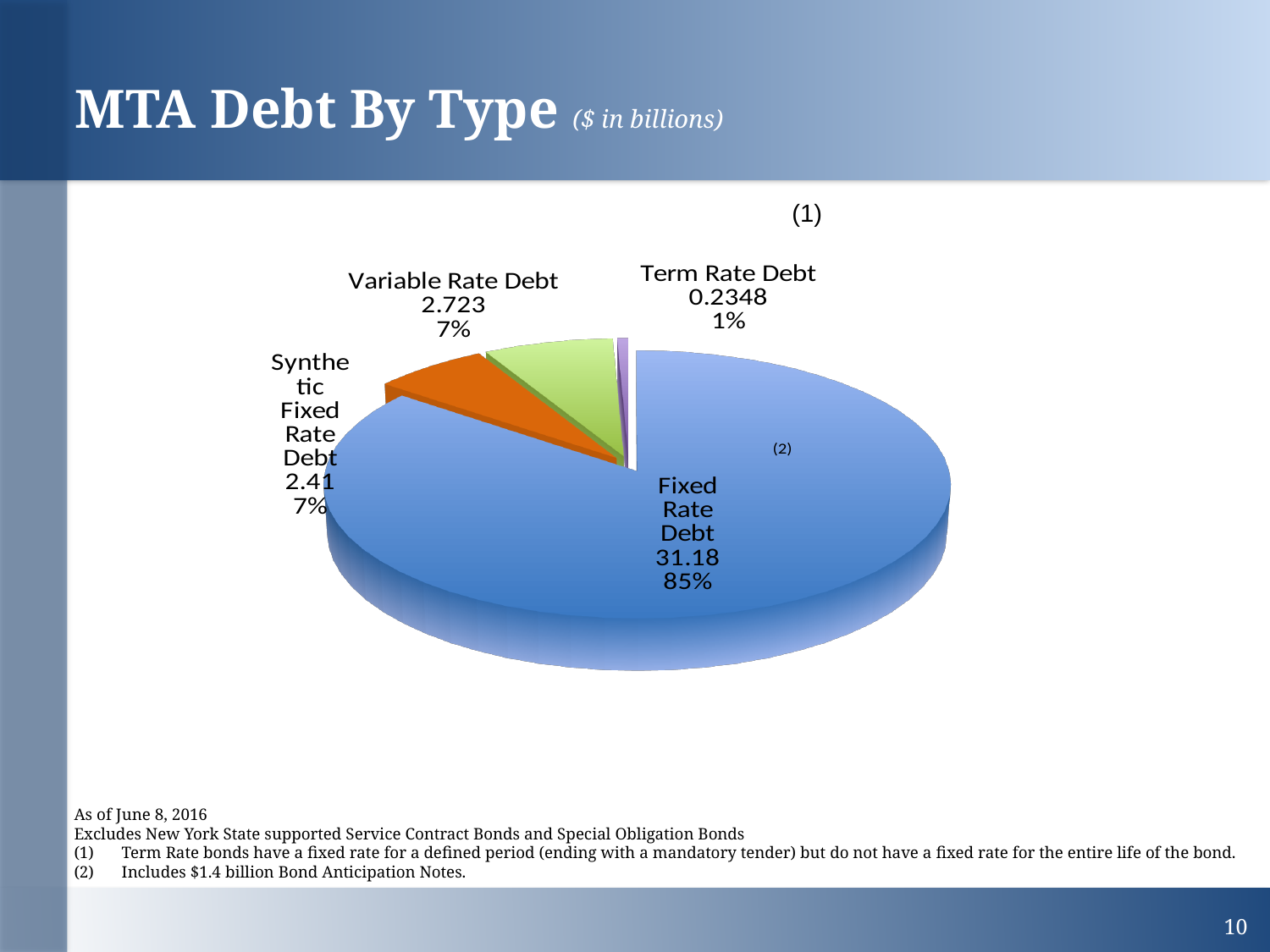
What percentage share of the pie does Term Rate Debt represent? 1% What is the value for Term Rate Debt? 0.2348 What percentage share of the pie does Fixed Rate Debt represent? 85% What is the value for Variable Rate Debt? 2.723 What is the value for Fixed Rate Debt? 31.18 What is the difference between the values for Variable Rate Debt and Synthetic Fixed Rate Debt? 0.313 Which debt type has the largest share of the pie? Fixed Rate Debt What is the value for Synthetic Fixed Rate Debt? 2.41 Which debt type has the smallest share of the pie? Term Rate Debt What kind of chart is shown on the slide? pie chart What is the title of the chart on the slide? MTA Debt By Type ($ in billions) How many slices does the pie chart have? 4